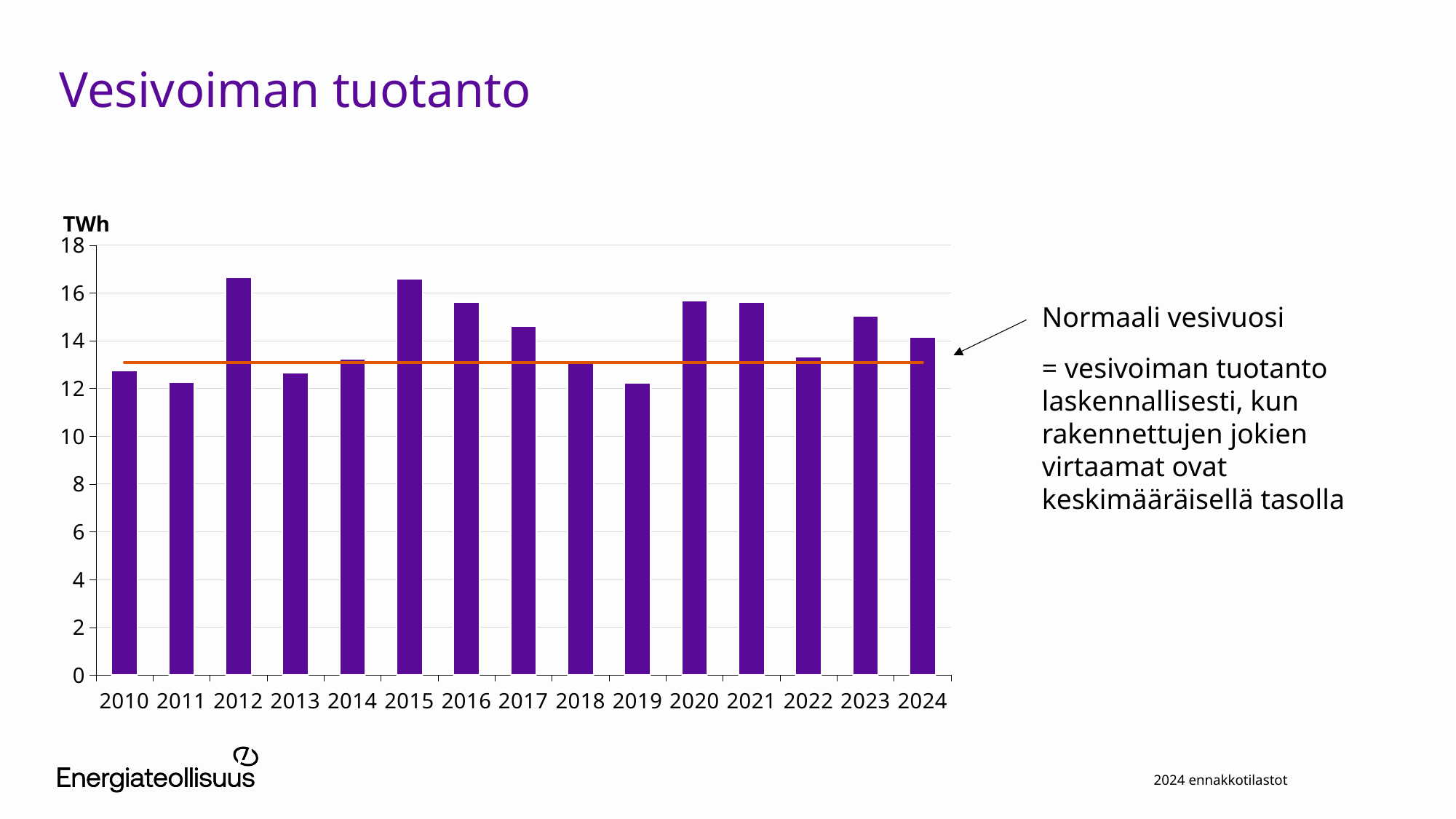
Is the value for 2024 greater or less than 16? less Which year has the larger value, 2017 or 2019? 2017 What kind of chart is shown on the slide? bar chart What is the title of the chart on the slide? Vesivoiman tuotanto Do the values rise or fall from 2015 to 2019? fall Is the value for 2012 greater or less than 16? greater Which year has the larger value, 2023 or 2024? 2023 Is the value for 2019 greater or less than 14? less What unit is shown on the vertical axis of the chart? TWh Which year has the larger value, 2012 or 2013? 2012 How many years are shown on the x axis of the chart? 15